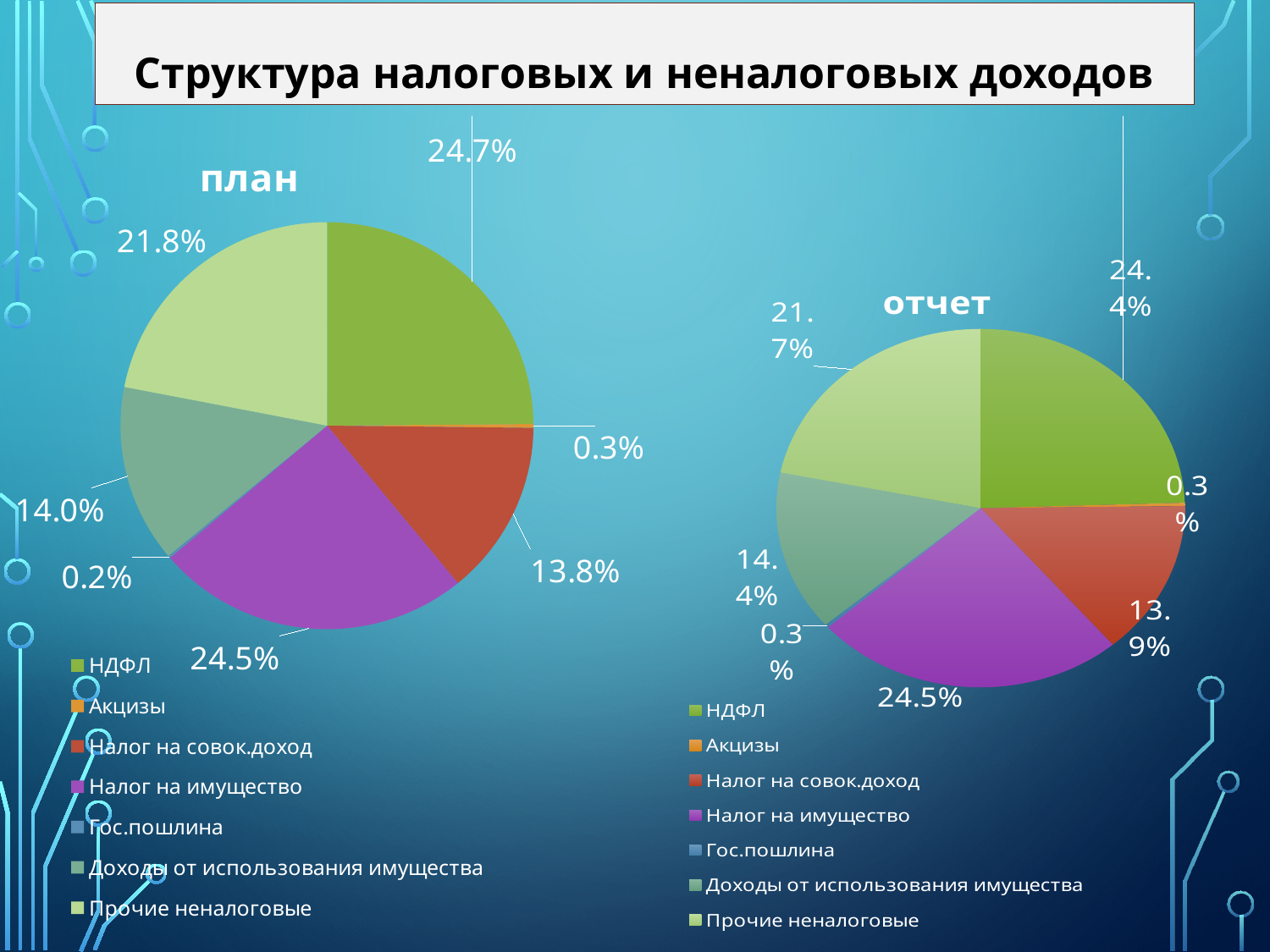
In the 'план' chart, what is the share for Налог на совок.доход? 13.8% How many categories does the legend of the 'план' chart list? 7 In the 'отчет' chart, which is larger: the share for НДФЛ or the share for Прочие неналоговые? НДФЛ In the 'план' chart, what is the share for НДФЛ? 24.7% What is the title of the slide? Структура налоговых и неналоговых доходов In the 'план' chart, what is the difference between the shares of Налог на имущество and Налог на совок.доход? 10.7% In the 'план' chart, which category has the largest share? НДФЛ In the 'отчет' chart, what is the share for Доходы от использования имущества? 14.4% What type of charts are shown on the slide? Pie charts In the 'отчет' chart, which category has the largest share? Налог на имущество In the 'план' chart, which category has the smallest share? Гос.пошлина In the 'отчет' chart, what is the share for Прочие неналоговые? 21.7%